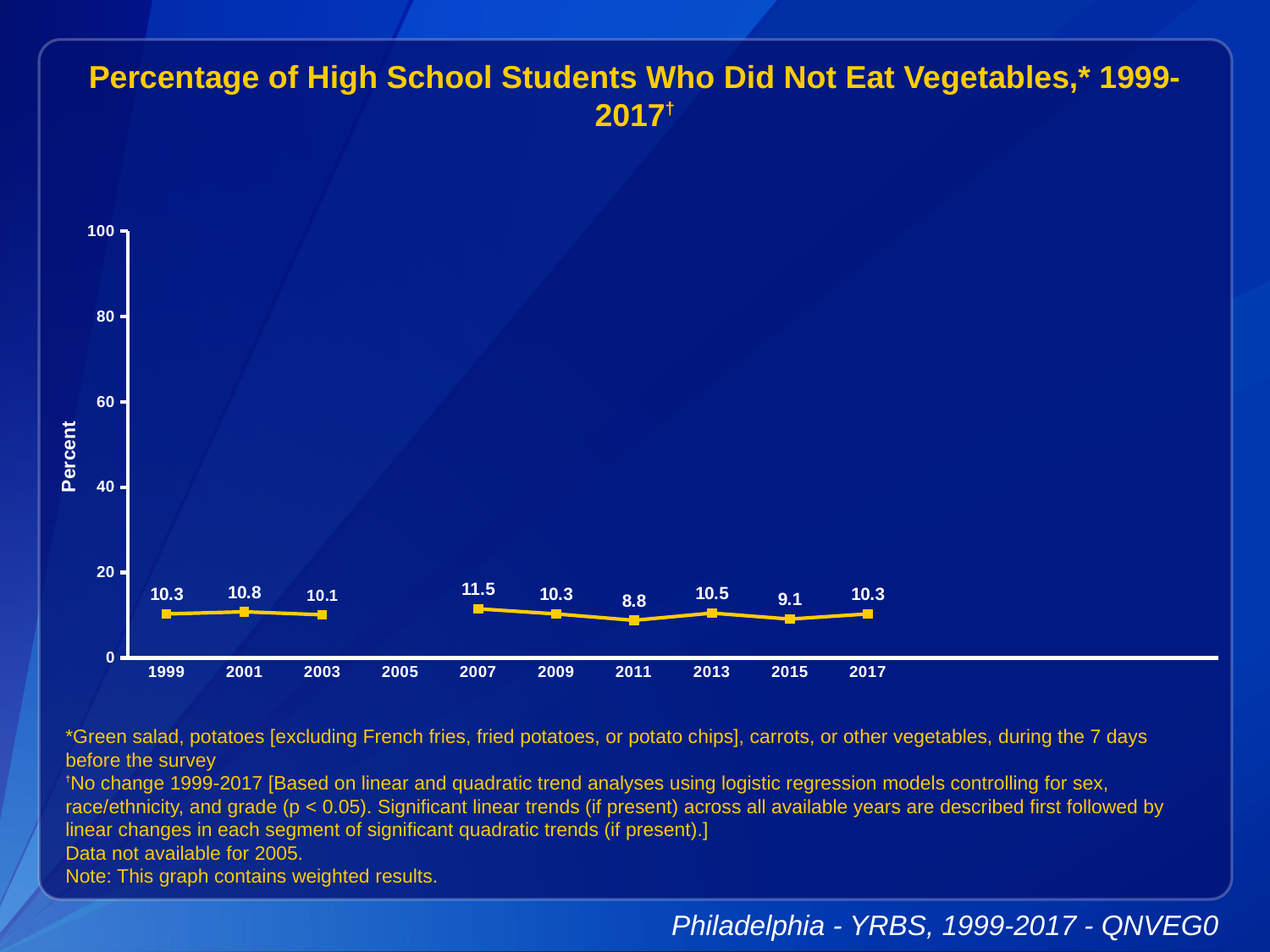
What is the value plotted for 2017? 10.3 Which year on the x axis has no data point plotted? 2005 What is the value plotted for 2011? 8.8 Is the value for 2013 greater or less than 20? less What kind of chart is shown on the slide? line chart What is the difference between the values for 2007 and 2011? 2.7 Which year has the lowest percentage of students who did not eat vegetables? 2011 What percentage of high school students did not eat vegetables in 2007? 11.5 Which year has a larger value, 2001 or 2015? 2001 What is the label on the y axis? Percent Which year has the highest percentage of students who did not eat vegetables? 2007 How many years have data points plotted on the chart? 9